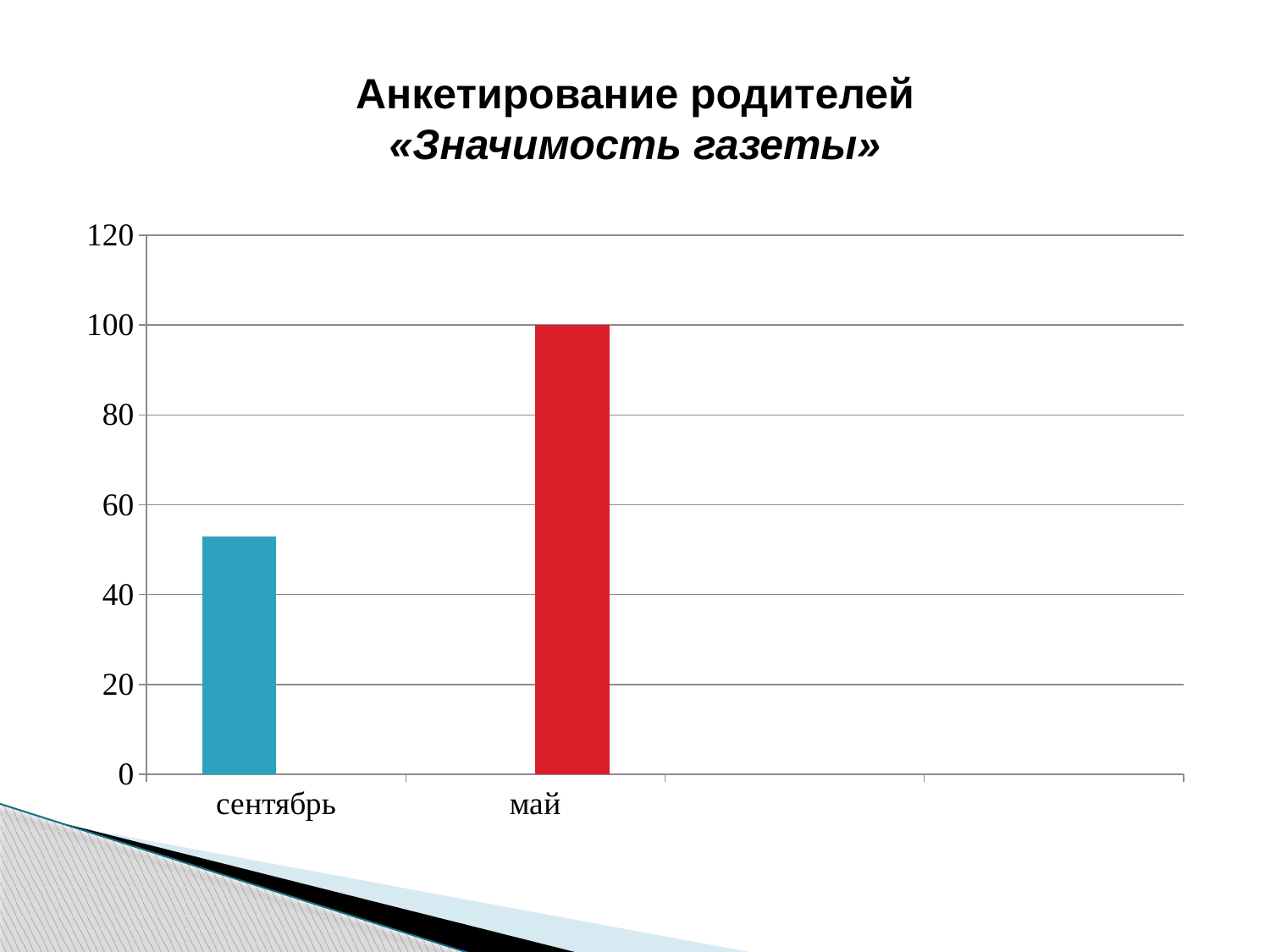
Is the value for май greater or less than 80? greater Which category has the lowest bar? сентябрь Is the value for сентябрь greater or less than 60? less Is the value for сентябрь greater or less than 40? greater Which category has the highest bar? май What is the title of the slide above the chart? Анкетирование родителей «Значимость газеты» What is the value for май? 100 What kind of chart is shown on the slide? bar chart Which is larger, the value for сентябрь or the value for май? май What colour is the bar for май? red Do the values rise or fall from сентябрь to май? rise How many categories are plotted on the x axis? 2